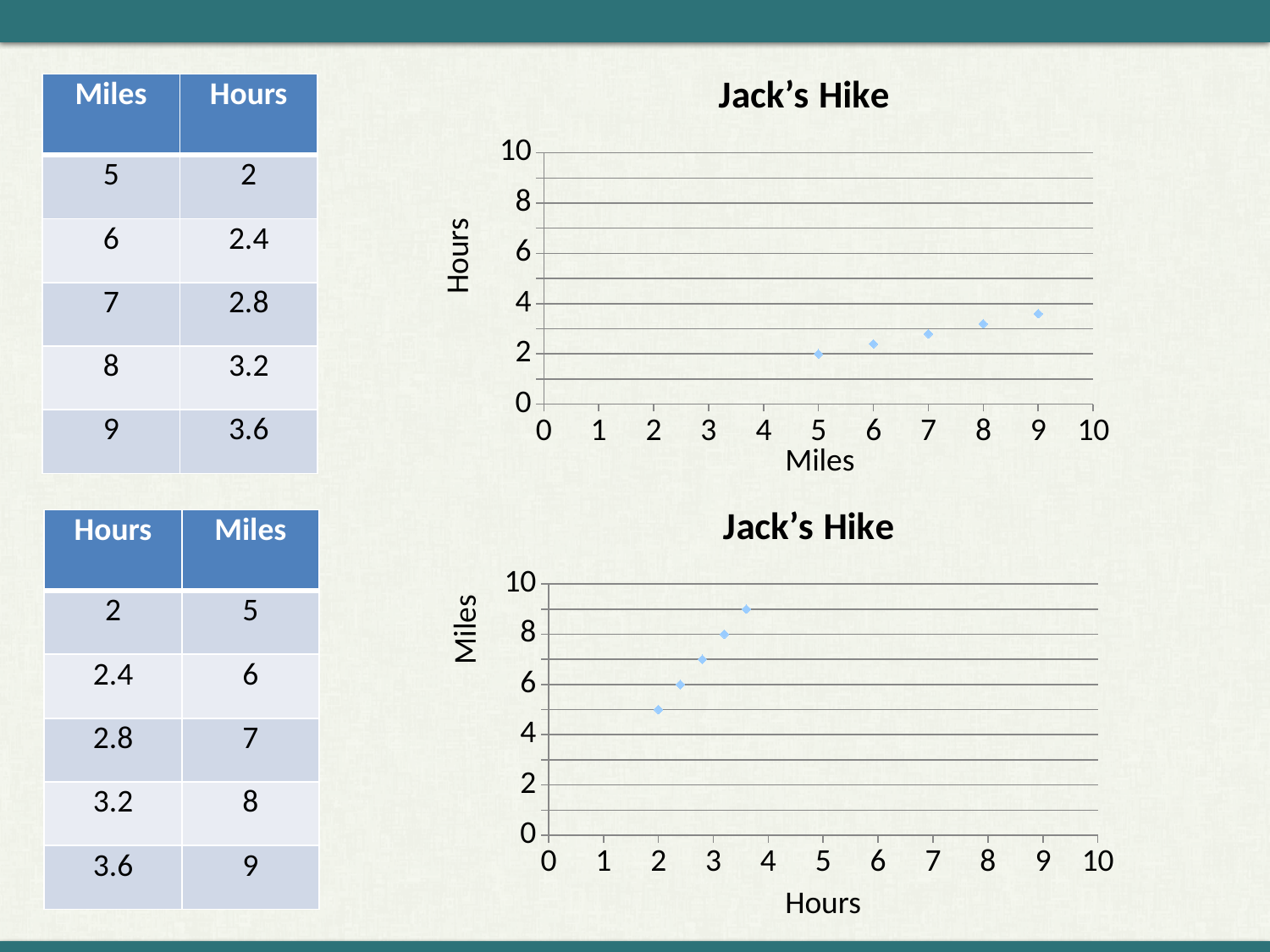
In the top chart, which miles value has the highest hours? 9 In the bottom chart, how many miles correspond to 3.2 hours? 8 In the top chart, is the hours value at 7 miles greater or less than 4? less In the top chart, what is the difference in hours between 9 miles and 5 miles? 1.6 In the top chart, how many hours correspond to 5 miles? 2 In the bottom chart, which has more miles: 2 hours or 2.8 hours? 2.8 hours In the top chart, do the hours rise or fall as miles increase? rise How many data points are plotted in the top chart? 5 What is the y-axis title of the bottom chart? Miles In the top chart, how many hours correspond to 9 miles? 3.6 What kind of chart is the top chart on the slide? scatter chart In the bottom chart, is the miles value at 3.6 hours greater or less than 8? greater